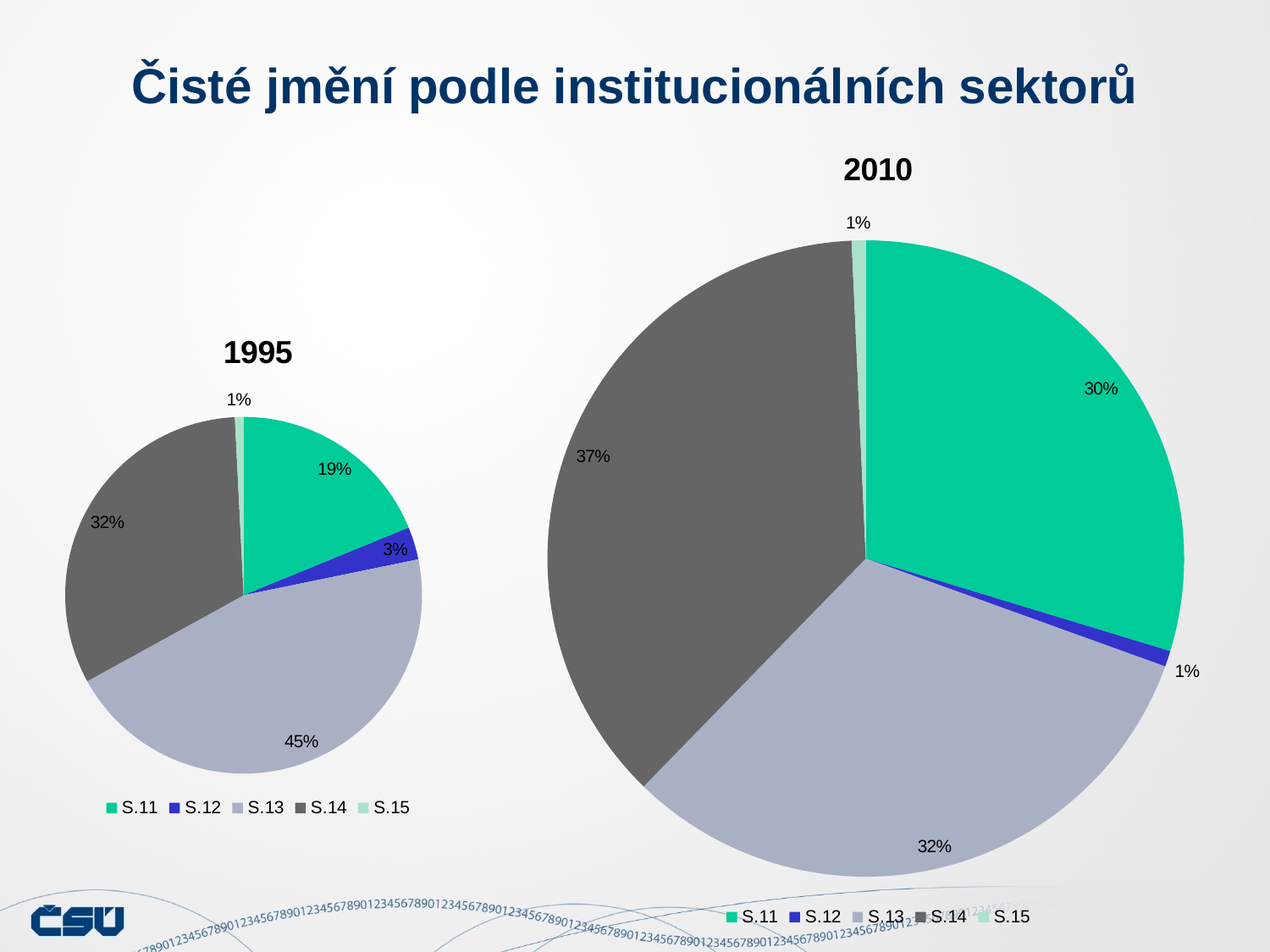
In the 2010 pie chart, which is larger, the share of S.13 or the share of S.11? S.13 In the 2010 pie chart, what share does S.14 have? 37% In the 1995 pie chart, what share does S.13 have? 45% In the 1995 pie chart, which sector has the largest share? S.13 In the 2010 pie chart, which sector has the largest share? S.14 In the 1995 pie chart, what share does S.12 have? 3% What type of chart is used to show the 2010 data? Pie chart What is the title of the slide? Čisté jmění podle institucionálních sektorů In the 1995 pie chart, which sector has the smallest share? S.15 In the 2010 pie chart, what share does S.11 have? 30% How many sectors does the legend of the 1995 pie chart list? 5 What is the difference between the share of S.11 in the 2010 pie chart and in the 1995 pie chart? 11 percentage points